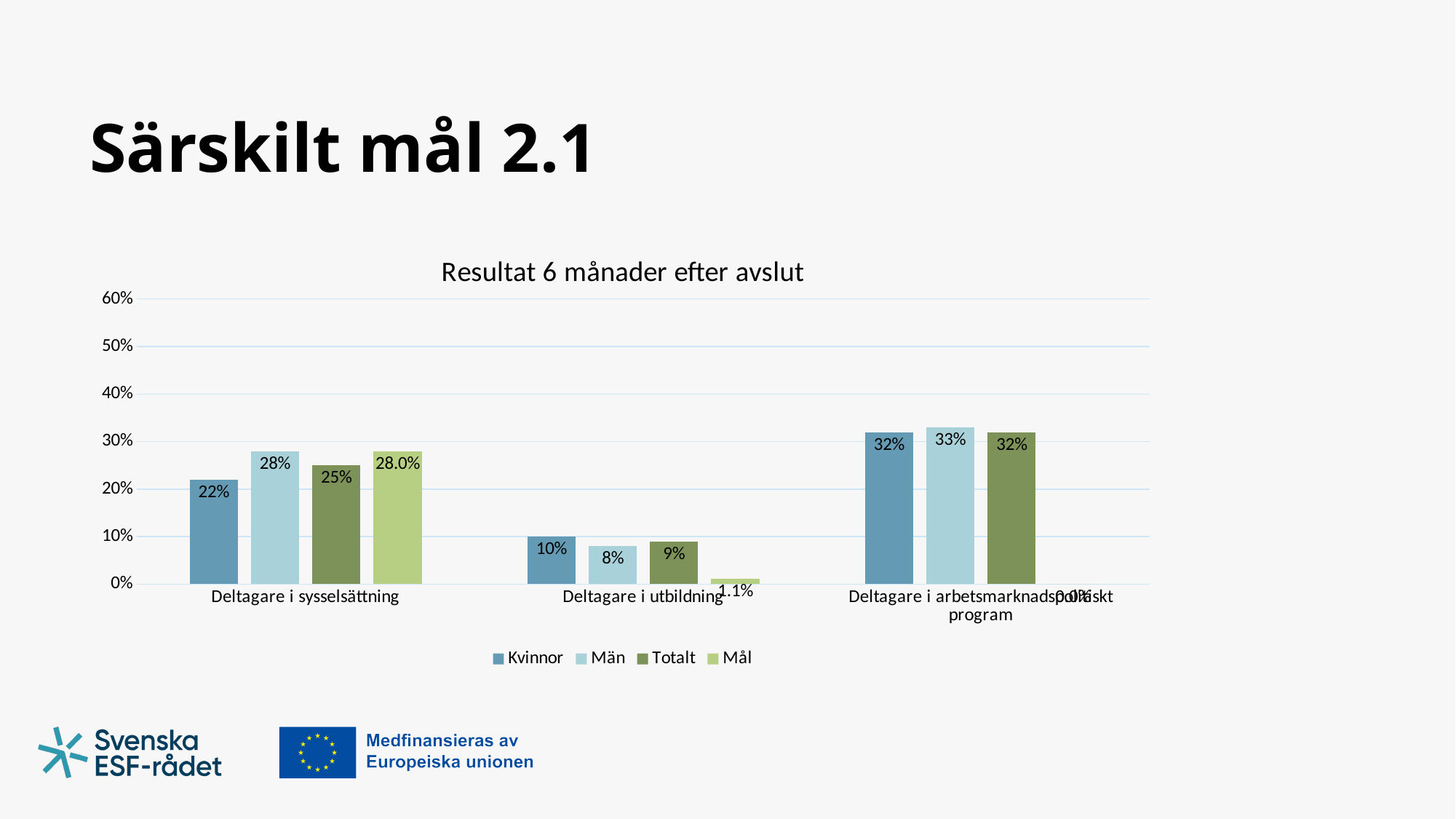
What is the value for Kvinnor in the category Deltagare i sysselsättning? 22% In which category is the Totalt value highest? Deltagare i arbetsmarknadspolitiskt program Is the value for Män in the category Deltagare i arbetsmarknadspolitiskt program greater or less than 30%? greater What is the value for Män in the category Deltagare i utbildning? 8% How many categories are shown on the x axis? 3 What type of chart is shown on the slide? Bar chart How many series does the legend list? 4 What is the value for Mål in the category Deltagare i sysselsättning? 28.0% What is the difference between the Män and Kvinnor values in the category Deltagare i sysselsättning? 6% What is the title of the chart? Resultat 6 månader efter avslut What is the value for Totalt in the category Deltagare i arbetsmarknadspolitiskt program? 32% Which is larger in the category Deltagare i utbildning, the value for Kvinnor or the value for Män? Kvinnor